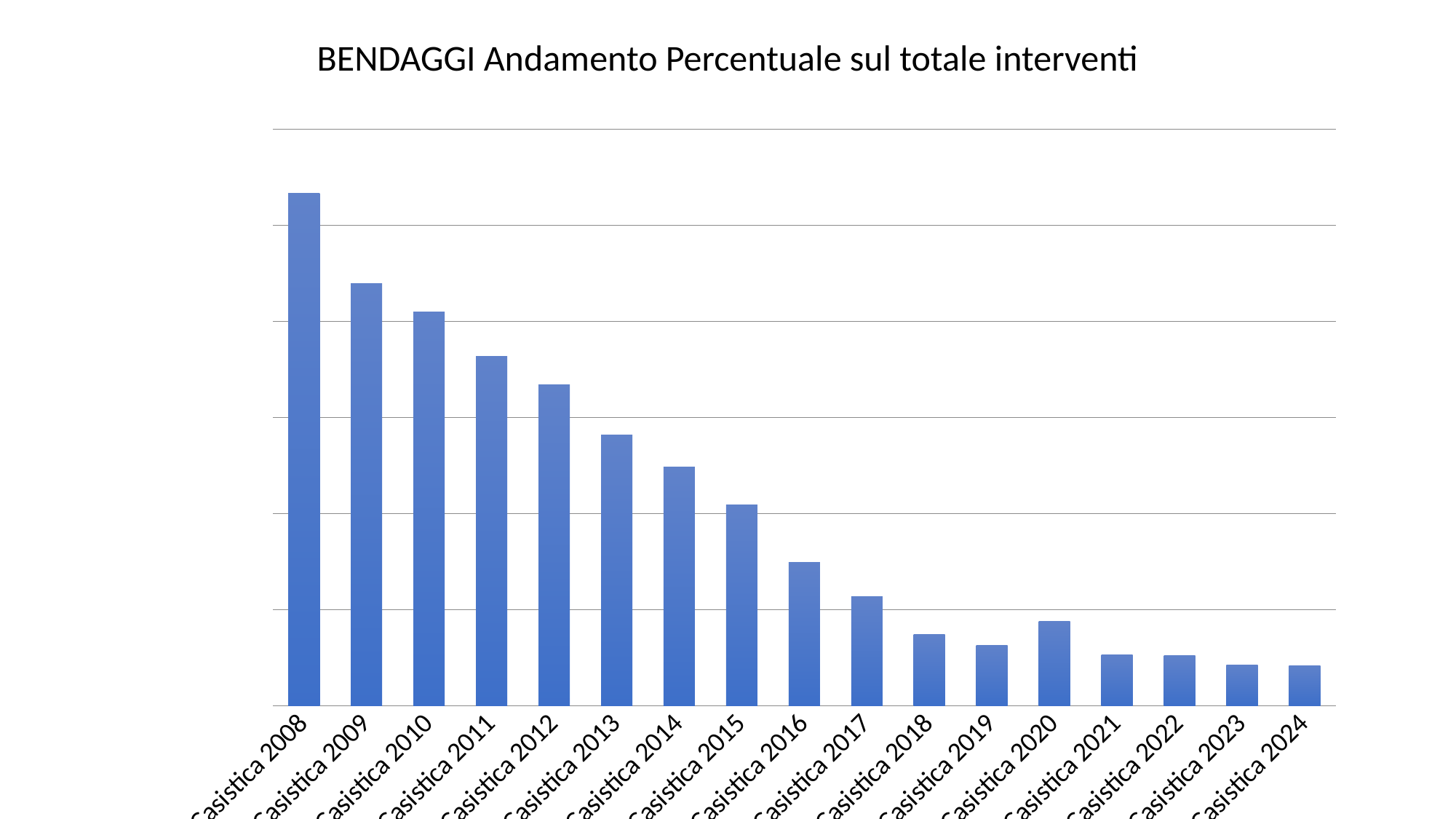
Which is larger, the value for Casistica 2018 or Casistica 2021? Casistica 2018 Which is larger, the value for Casistica 2009 or Casistica 2012? Casistica 2009 What is the title of the chart? BENDAGGI Andamento Percentuale sul totale interventi Which is larger, the value for Casistica 2014 or Casistica 2015? Casistica 2014 What kind of chart is shown on the slide? bar chart What is the label of the first category on the x axis? Casistica 2008 Do the values generally rise or fall from Casistica 2008 to Casistica 2024? fall Which category has the highest value? Casistica 2008 How many categories (bars) are plotted in the chart? 17